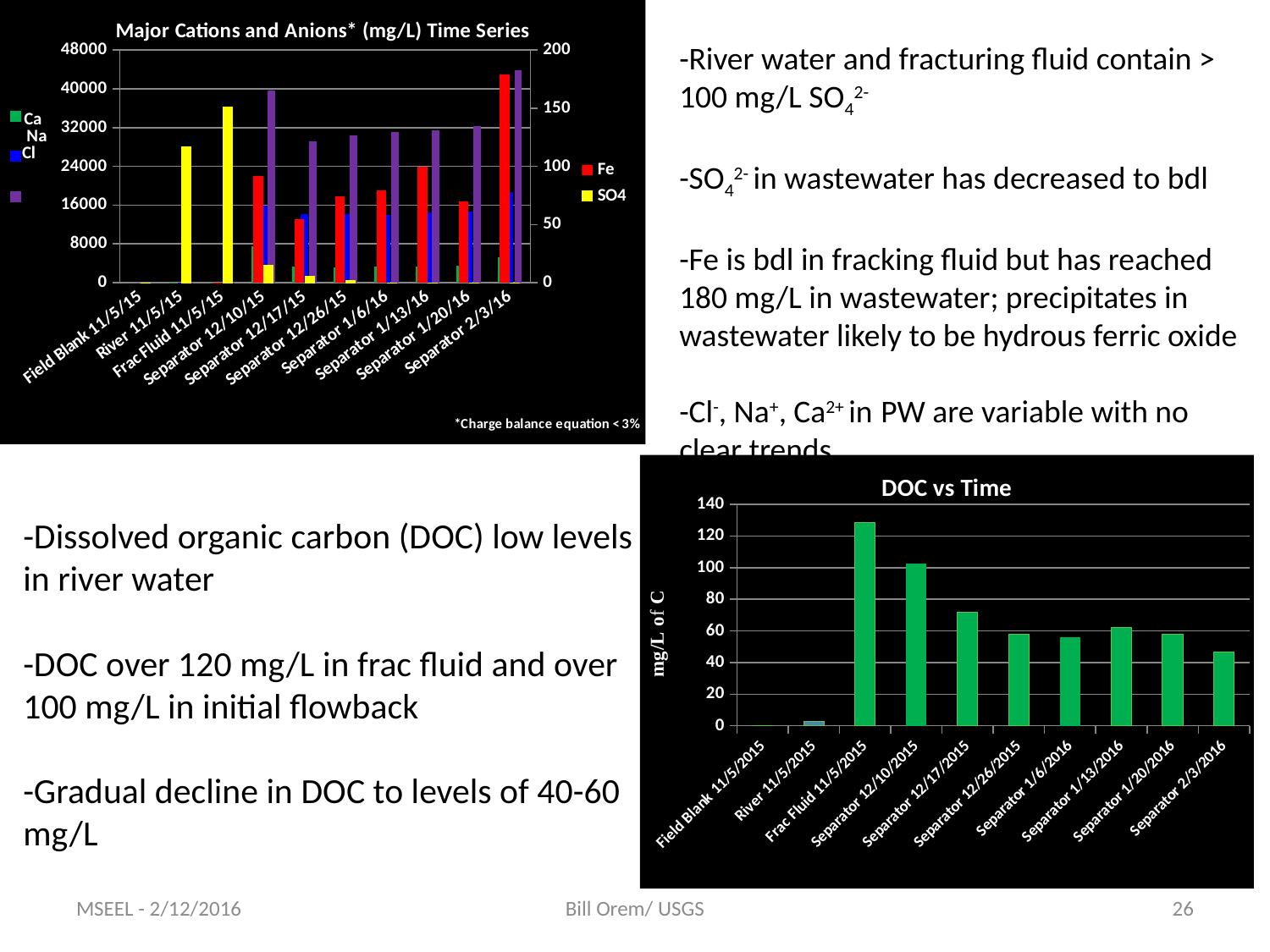
What is the y-axis label of the 'DOC vs Time' chart? mg/L of C In the 'DOC vs Time' chart, which category has the highest value? Frac Fluid 11/5/2015 In the 'DOC vs Time' chart, is the value for Separator 2/3/2016 greater or less than 60? less In the 'Major Cations and Anions* (mg/L) Time Series' chart, which category has the highest Fe value? Separator 2/3/16 What kind of chart is the 'DOC vs Time' chart? bar chart In the 'DOC vs Time' chart, which is larger: the value for Separator 12/17/2015 or the value for Separator 2/3/2016? Separator 12/17/2015 In the 'DOC vs Time' chart, which category has the lowest value? Field Blank 11/5/2015 In the 'DOC vs Time' chart, do the values generally rise or fall from Frac Fluid 11/5/2015 to Separator 2/3/2016? fall In the 'Major Cations and Anions* (mg/L) Time Series' chart, which category has the highest SO4 value? Frac Fluid 11/5/15 In the 'DOC vs Time' chart, is the value for Frac Fluid 11/5/2015 greater or less than 120? greater How many categories are shown on the x axis of the 'DOC vs Time' chart? 10 In the 'DOC vs Time' chart, is the value for Separator 12/10/2015 greater or less than 100? greater